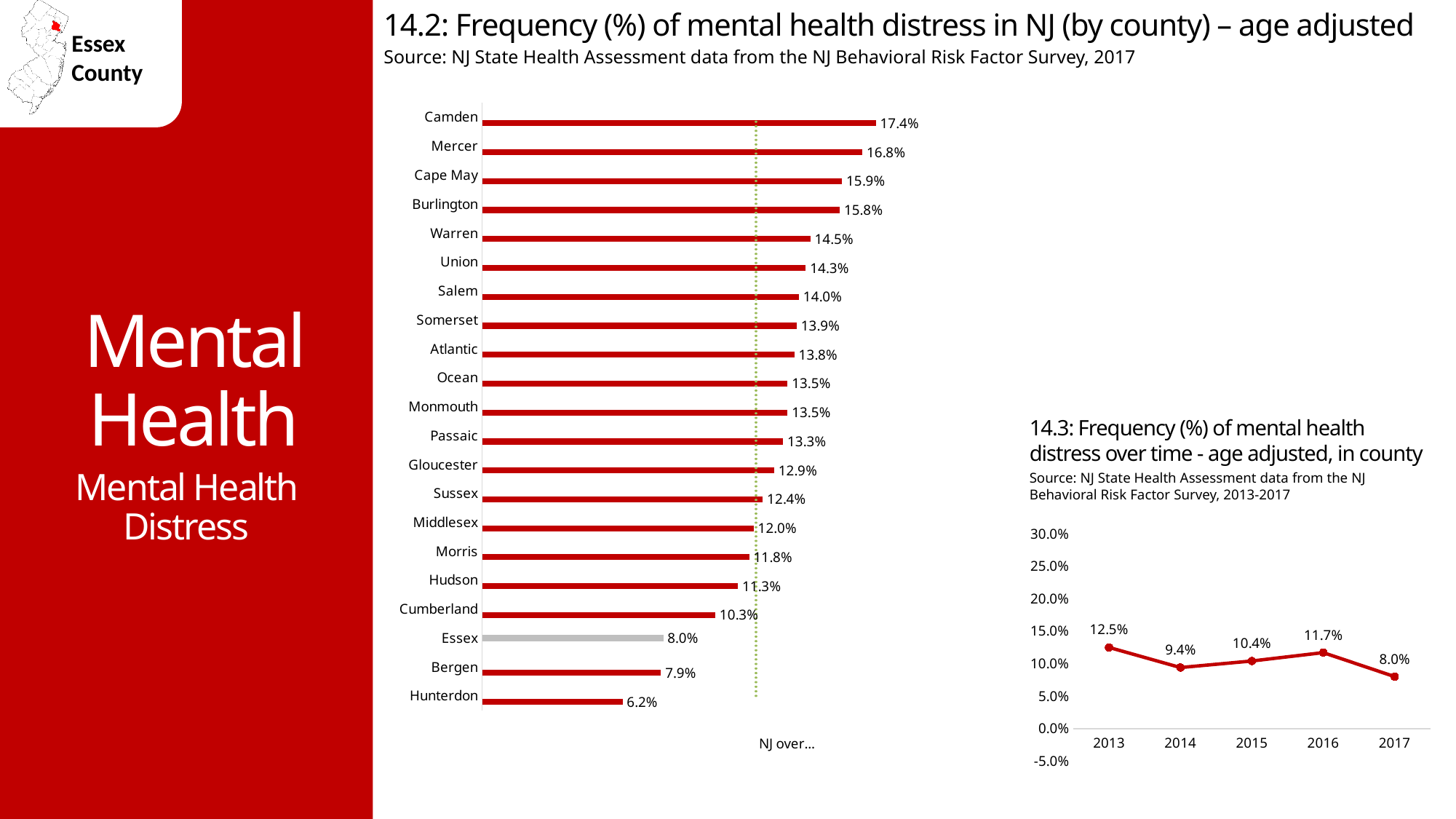
What kind of chart is chart 14.3 (over time)? Line chart In the chart 14.2 (by county), which county has the highest value? Camden In the chart 14.3 (over time), what is the difference between 2013 and 2017? 4.5% In the chart 14.2 (by county), which is larger, the value for Mercer or the value for Warren? Mercer In the chart 14.2 (by county), how many counties are shown? 21 In the chart 14.2 (by county), what is the difference between Camden and Hunterdon? 11.2% What kind of chart is chart 14.2 (by county)? Bar chart In the chart 14.2 (by county), what is the value for Essex? 8.0% In the chart 14.3 (over time), which year has the lowest value? 2017 In the chart 14.2 (by county), what is the value for Camden? 17.4% In the chart 14.2 (by county), which county has the lowest value? Hunterdon In the chart 14.3 (over time), what is the value for 2016? 11.7%